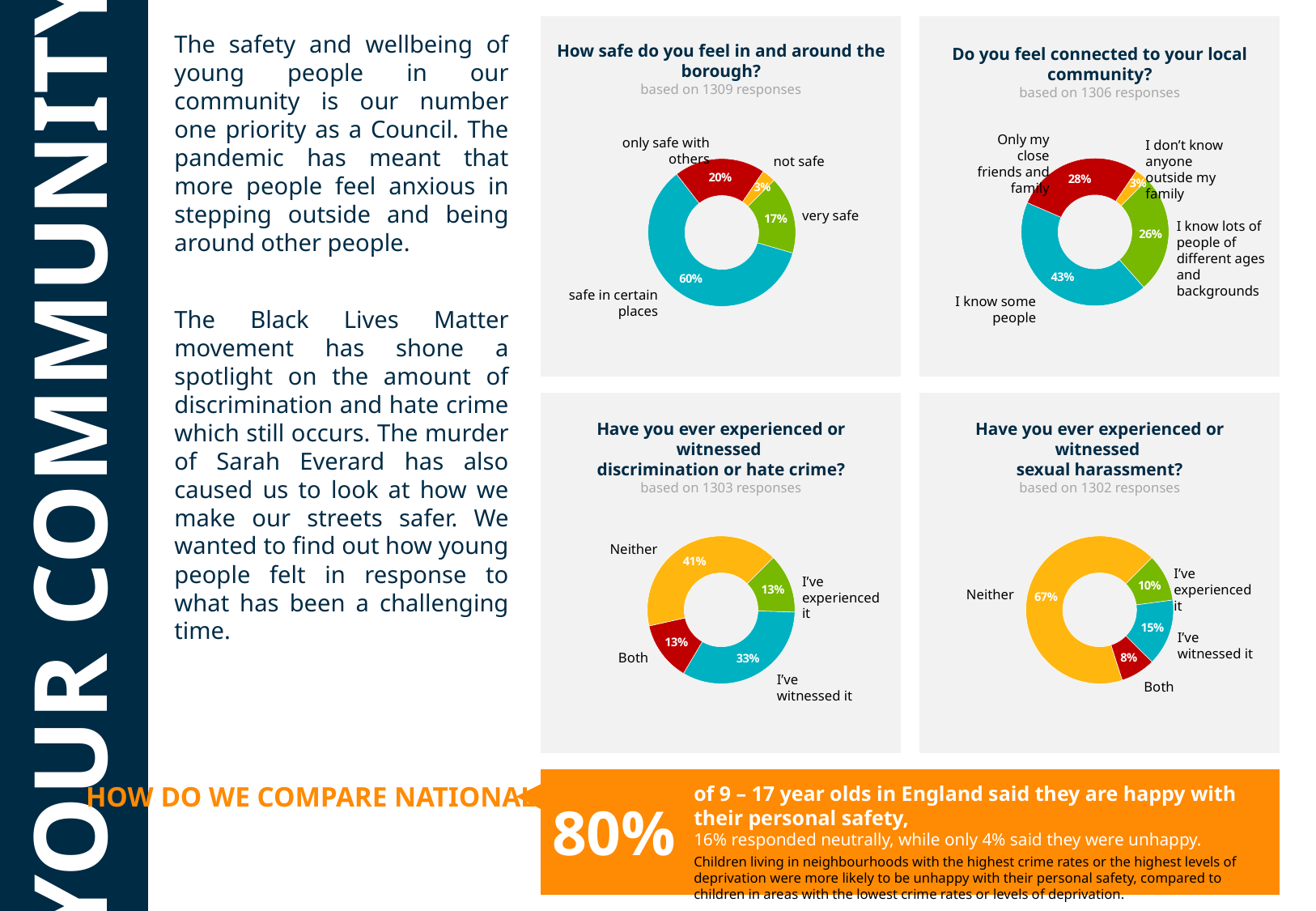
In the chart 'Do you feel connected to your local community?', what percentage said 'I know some people'? 43% What type of chart is used for 'How safe do you feel in and around the borough?' Donut (pie) chart In the chart 'Do you feel connected to your local community?', which is larger: 'Only my close friends and family' or 'I know lots of people of different ages and backgrounds'? Only my close friends and family In the chart 'Have you ever experienced or witnessed discrimination or hate crime?', what percentage said they have witnessed it? 33% In the chart 'How safe do you feel in and around the borough?', what percentage of respondents said they feel safe in certain places? 60% In the chart 'Have you ever experienced or witnessed sexual harassment?', what percentage answered 'Neither'? 67% In the chart 'How safe do you feel in and around the borough?', which response has the smallest share? not safe In the chart 'Have you ever experienced or witnessed discrimination or hate crime?', how many response categories are shown? 4 In the chart 'Have you ever experienced or witnessed sexual harassment?', which response has the smallest share? Both In the chart 'How safe do you feel in and around the borough?', what is the difference between the 'only safe with others' share and the 'very safe' share? 3% In the chart 'Have you ever experienced or witnessed sexual harassment?', what is the difference between 'I've witnessed it' and 'I've experienced it'? 5% In the chart 'Do you feel connected to your local community?', which response has the largest share? I know some people